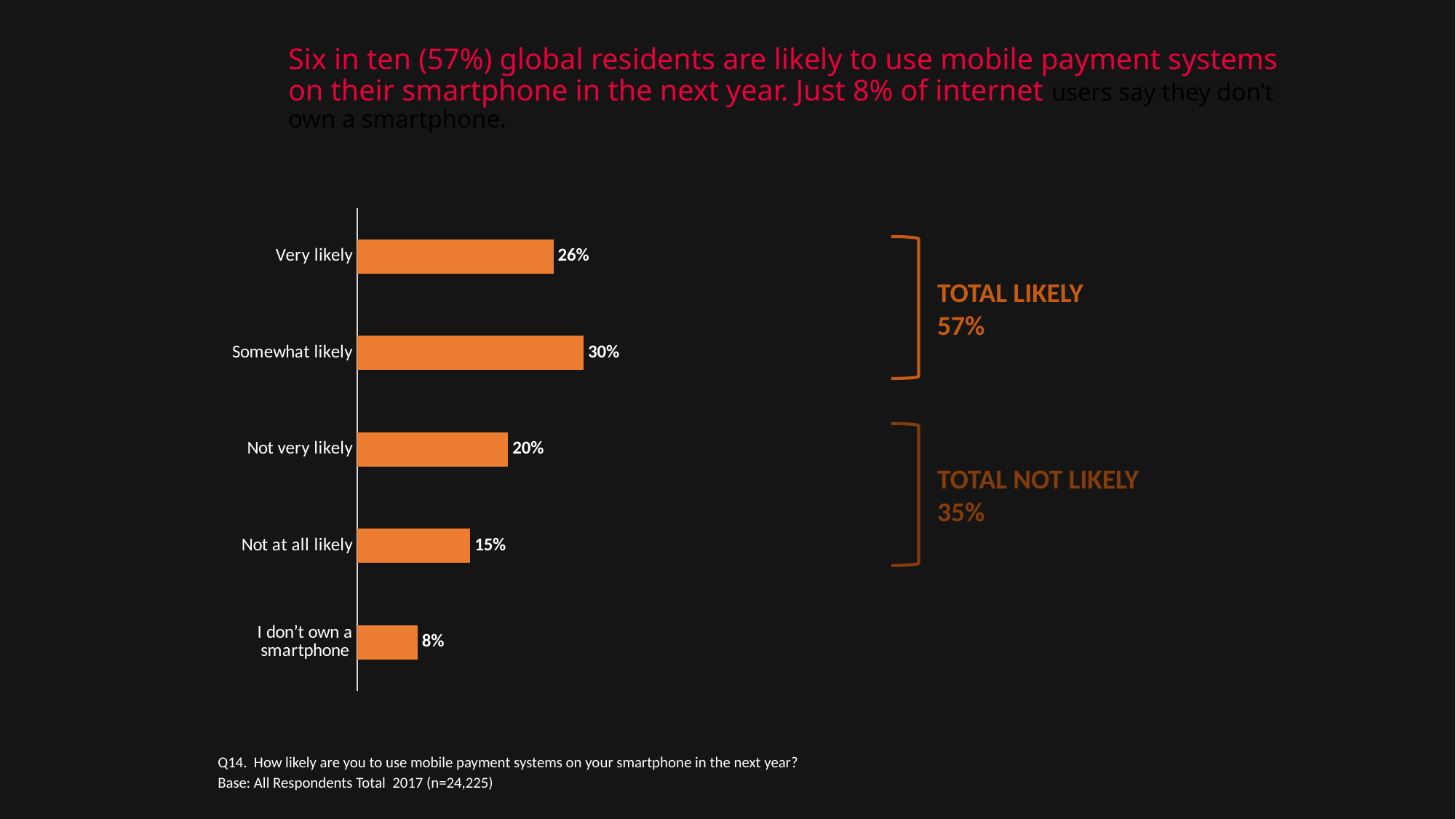
What is the difference between 'Not very likely' and 'Not at all likely'? 5% What kind of chart is shown on the slide? Bar chart What percentage of respondents say they don't own a smartphone? 8% What percentage of respondents are very likely to use mobile payment systems on their smartphone in the next year? 26% How many categories are shown in the chart? 5 What is the total for 'Very likely' and 'Somewhat likely' combined, as labelled on the slide? 57% What is the value for 'Somewhat likely'? 30% What is the 'TOTAL NOT LIKELY' figure shown on the slide? 35% Which is larger, 'Very likely' or 'Not very likely'? Very likely Which category has the lowest value? I don't own a smartphone Which category has the highest value? Somewhat likely What is the difference between 'Somewhat likely' and 'Very likely'? 4%